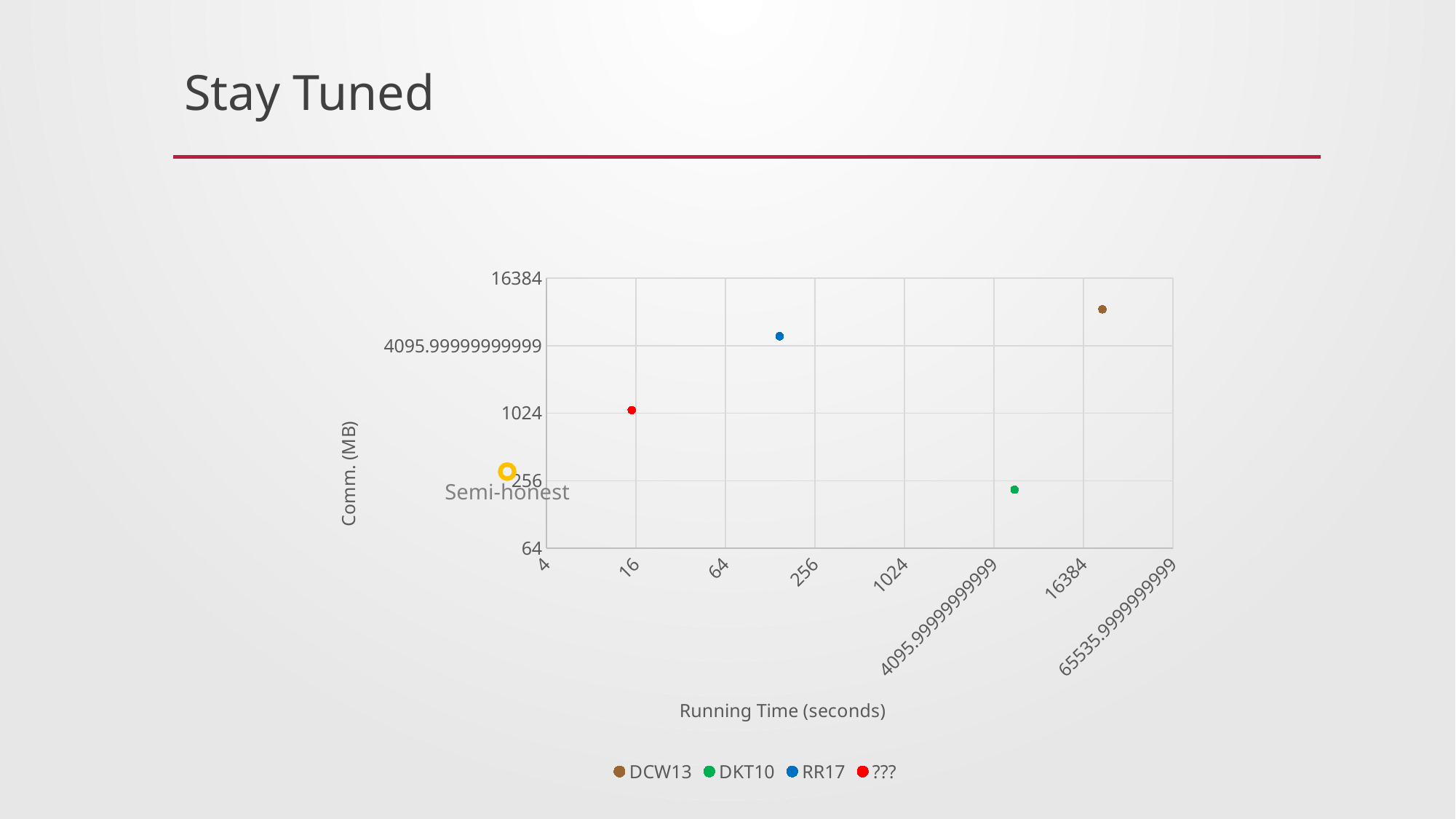
What is the label of the y axis? Comm. (MB) Is the Comm. (MB) value for DCW13 greater or less than 1024? greater Which has the larger Comm. (MB) value, RR17 or DKT10? RR17 Which series has the lowest Comm. (MB) value? DKT10 Is the running time for DKT10 greater or less than 1024 seconds? greater Which series has the highest Comm. (MB) value? DCW13 What is the label of the x axis? Running Time (seconds) Which series has the longest running time? DCW13 Is the Comm. (MB) value for DKT10 greater or less than 256? less How many series does the legend list? 4 Which series has the shortest running time? ??? What kind of chart is shown on the slide? scatter chart